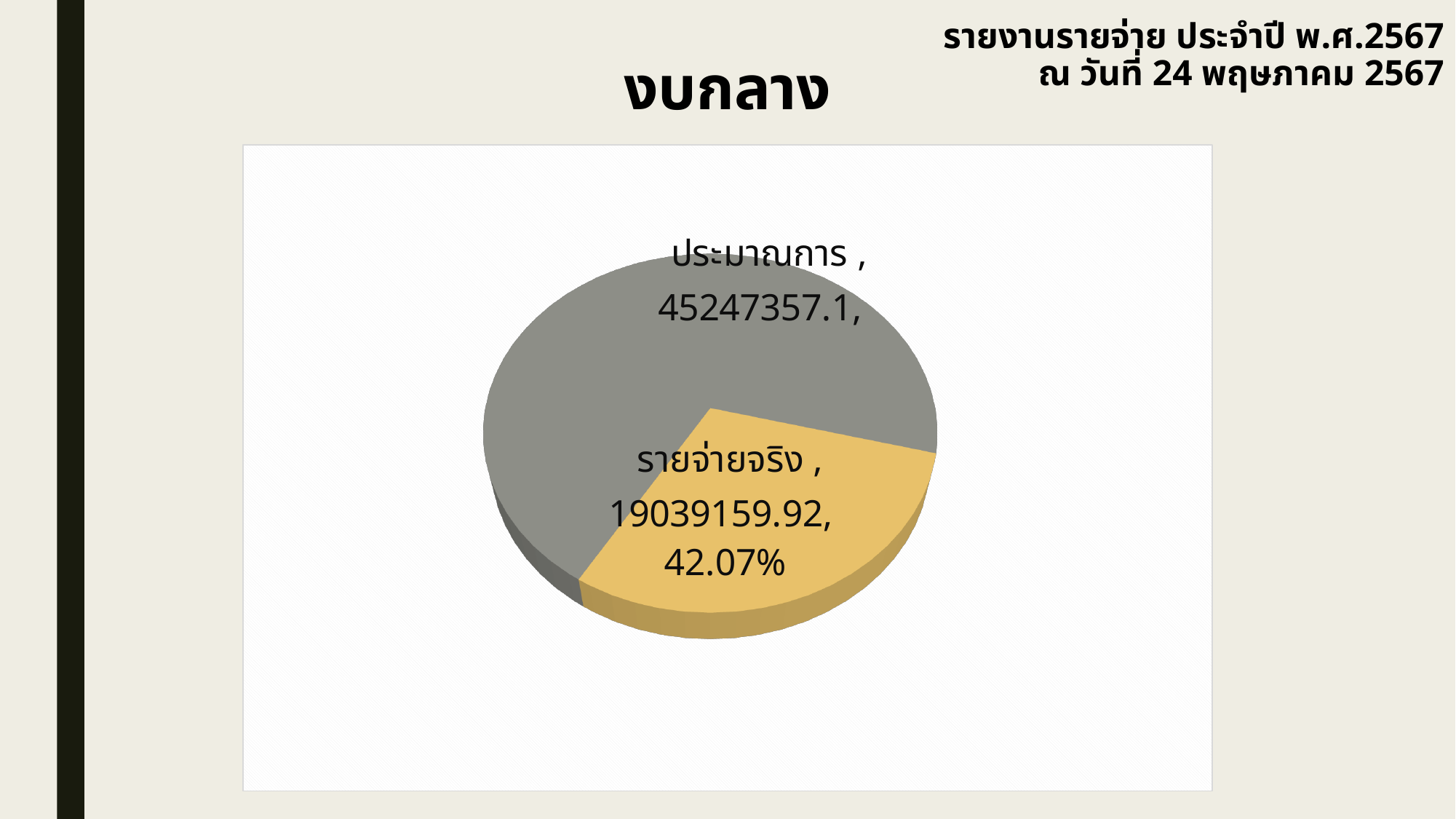
What colour is the slice for รายจ่ายจริง? yellow What kind of chart is shown on the slide? pie chart Which is larger, the value for ประมาณการ or the value for รายจ่ายจริง? ประมาณการ Which slice of the pie is the largest? ประมาณการ What is the difference between the value for ประมาณการ and the value for รายจ่ายจริง? 26208197.18 Which slice of the pie is the smallest? รายจ่ายจริง What percentage share of the pie is labelled for รายจ่ายจริง? 42.07% What is the value shown for รายจ่ายจริง? 19039159.92 What is the title of the chart on the slide? งบกลาง How many slices does the pie chart have? 2 What is the value shown for ประมาณการ? 45247357.1